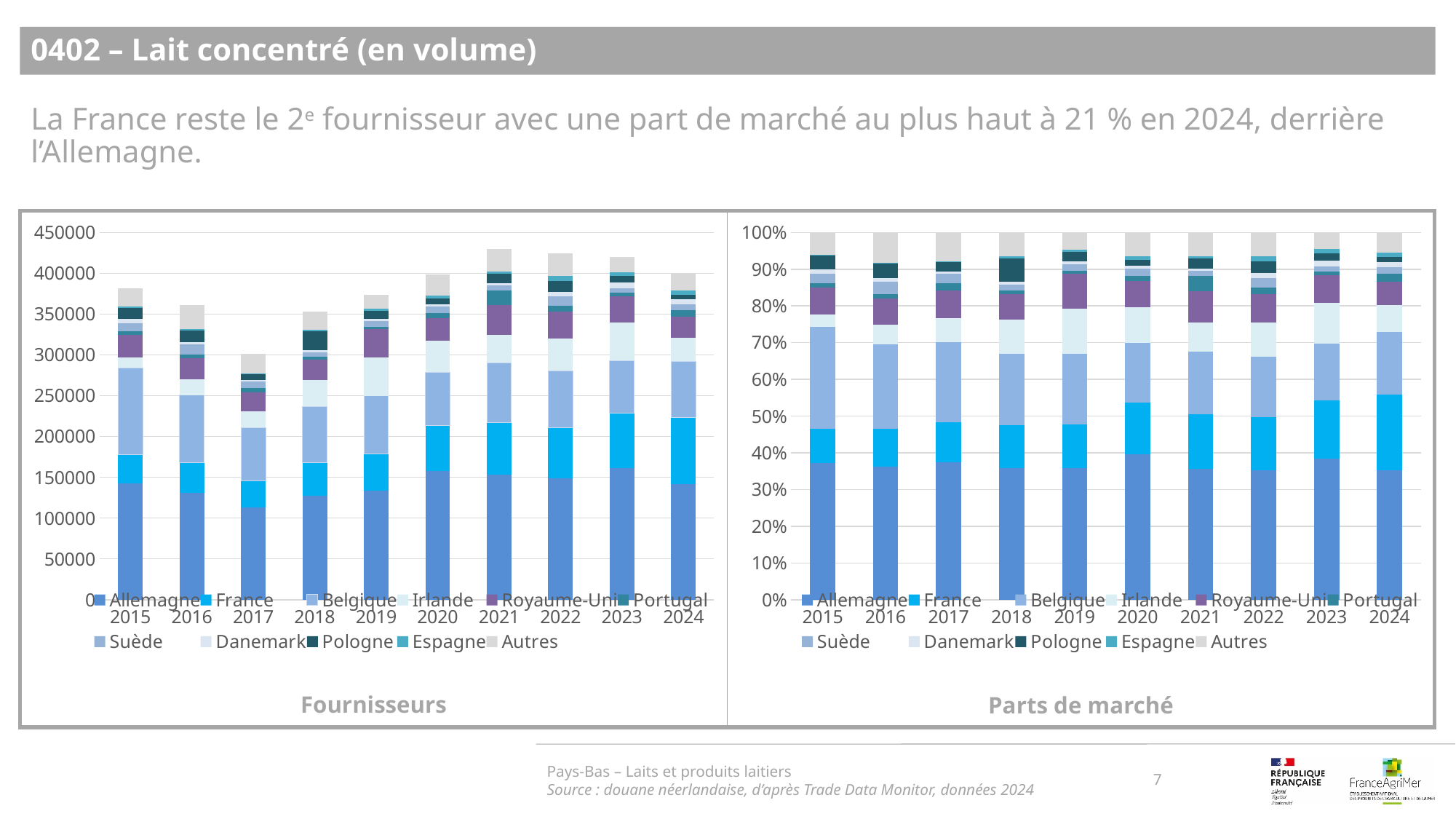
In the 'Fournisseurs' chart, is the total bar for 2017 greater or less than 350000? less In the 'Fournisseurs' chart, which segment is larger in 2015, Allemagne or France? Allemagne How many years are shown on the x axis of the 'Parts de marché' chart? 10 How many series does the legend of the 'Fournisseurs' chart list? 11 In the 'Fournisseurs' chart, do the total bars rise or fall from 2017 to 2021? rise In the 'Fournisseurs' chart, is the Allemagne segment for 2015 greater or less than 100000? greater In the 'Fournisseurs' chart, which total bar is larger, 2017 or 2021? 2021 Which series is listed first in the legend of the 'Parts de marché' chart? Allemagne In the 'Parts de marché' chart, is the Allemagne share for 2015 greater or less than 30%? greater What kind of chart is the 'Fournisseurs' chart on the left? stacked bar chart In the 'Fournisseurs' chart, which year has the lowest total bar? 2017